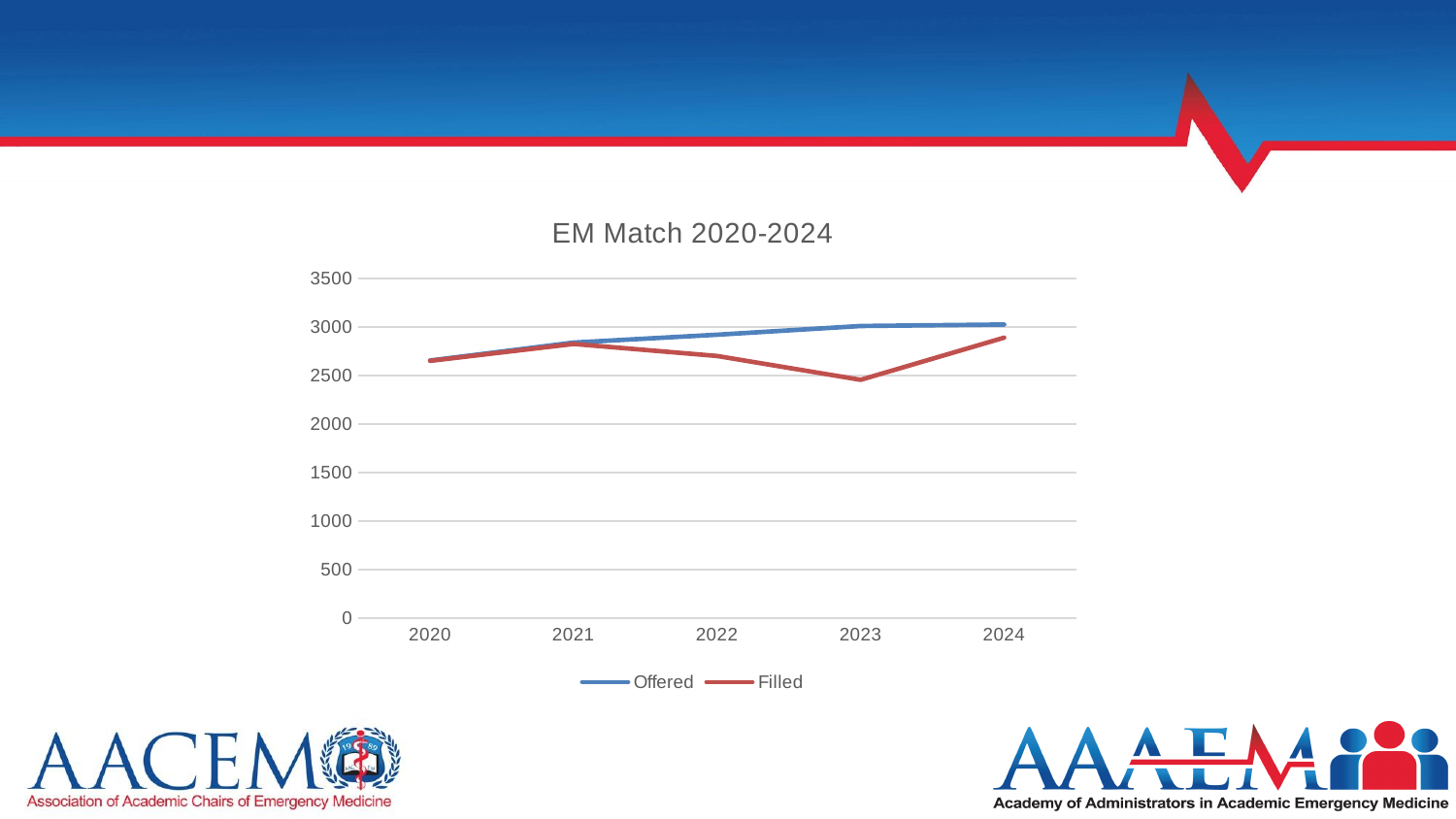
Is the value for Filled in 2024 greater or less than 3000? less How many years are plotted along the x axis? 5 In 2023, which series has the larger value, Offered or Filled? Offered Is the value for Offered in 2020 greater or less than 2500? greater Is the value for Filled in 2022 greater or less than 2500? greater What is the title of the chart? EM Match 2020-2024 In which year is the Filled series at its lowest? 2023 Which series is drawn in red? Filled Does the Offered series generally rise or fall from 2020 to 2024? rise What kind of chart is shown on the slide? Line chart How many series does the legend list? 2